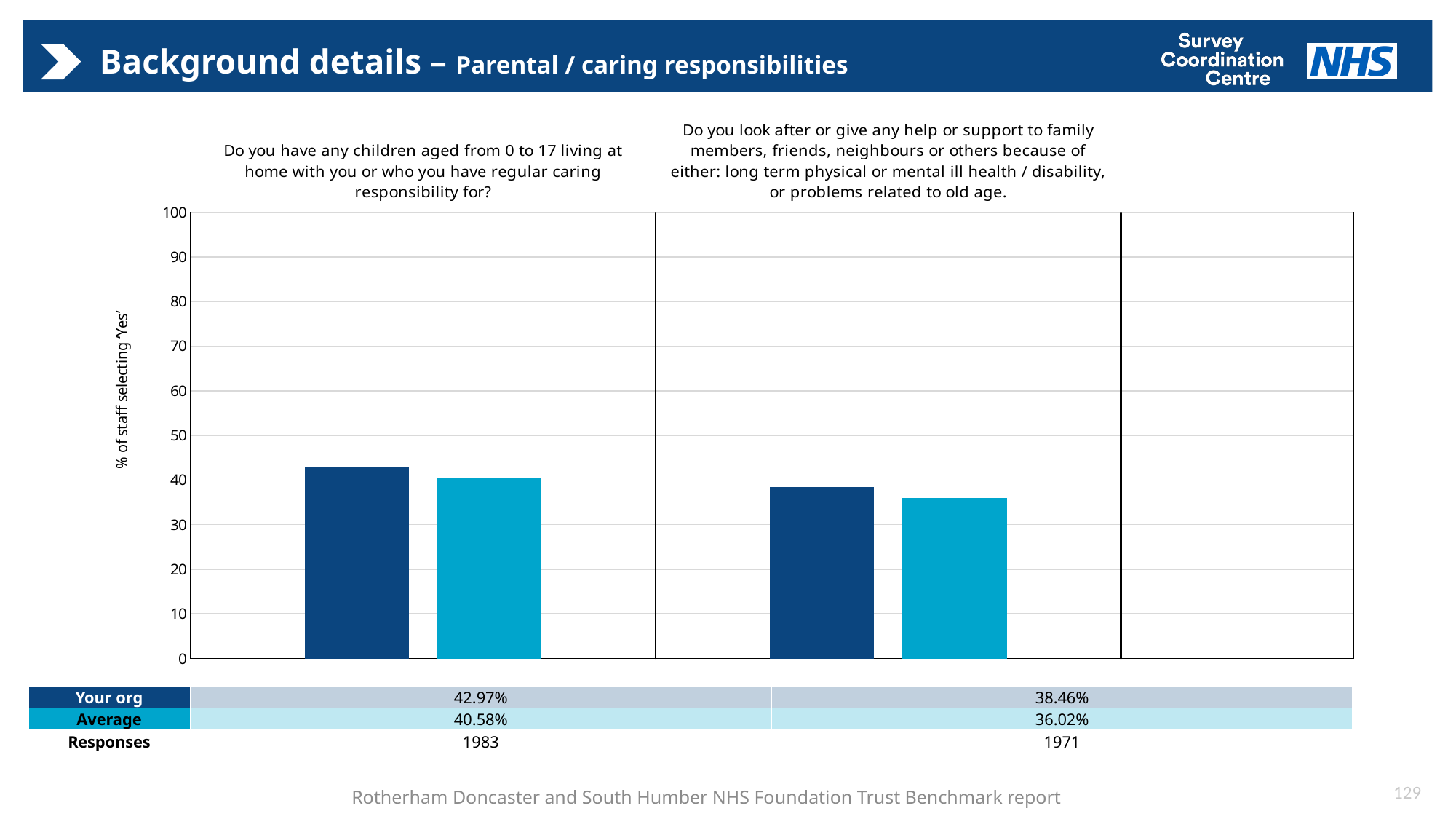
What is the Your org value for the question about looking after or giving help or support to family members, friends, neighbours or others? 38.46% How many responses were there for the question about having children aged 0 to 17 living at home? 1983 For the question about having children aged 0 to 17 living at home, which is larger: Your org or Average? Your org What is the Average value for the question about having children aged 0 to 17 living at home? 40.58% How many responses were there for the question about looking after or giving help or support to family members, friends, neighbours or others? 1971 What is the Average value for the question about looking after or giving help or support to family members, friends, neighbours or others? 36.02% What is the label on the vertical axis of the chart? % of staff selecting 'Yes' What is the difference between the Your org and Average values for the question about having children aged 0 to 17 living at home? 2.39% Is the Your org value for the question about looking after or giving help or support to family members greater or less than 40? less What kind of chart is shown on the slide? Bar chart What percentage of staff at your org selected 'Yes' to having children aged 0 to 17 living at home or with regular caring responsibility? 42.97% What is the difference between the Your org and Average values for the question about looking after or giving help or support to family members, friends, neighbours or others? 2.44%